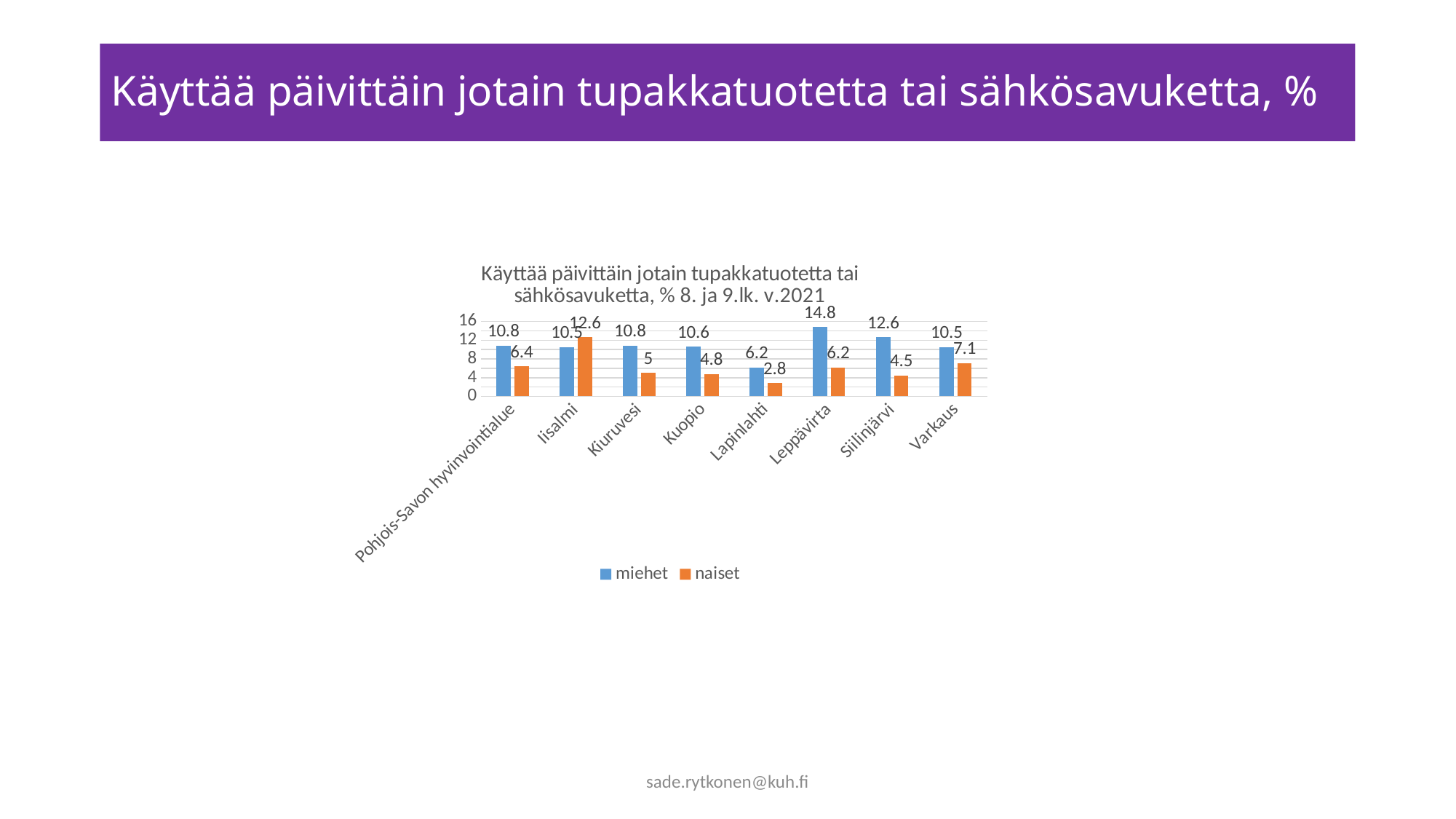
What kind of chart is shown on the slide? bar chart Which category has the lowest value for naiset? Lapinlahti What is the value for miehet in Leppävirta? 14.8 What is the value for naiset in Iisalmi? 12.6 What is the difference between the miehet and naiset values in Siilinjärvi? 8.1 How many categories are shown on the x axis? 8 Which colour represents the naiset series? orange What is the value for naiset in Lapinlahti? 2.8 In Iisalmi, which is larger, the value for miehet or for naiset? naiset How many series does the legend list? 2 Which category has the highest value for naiset? Iisalmi Which category has the highest value for miehet? Leppävirta